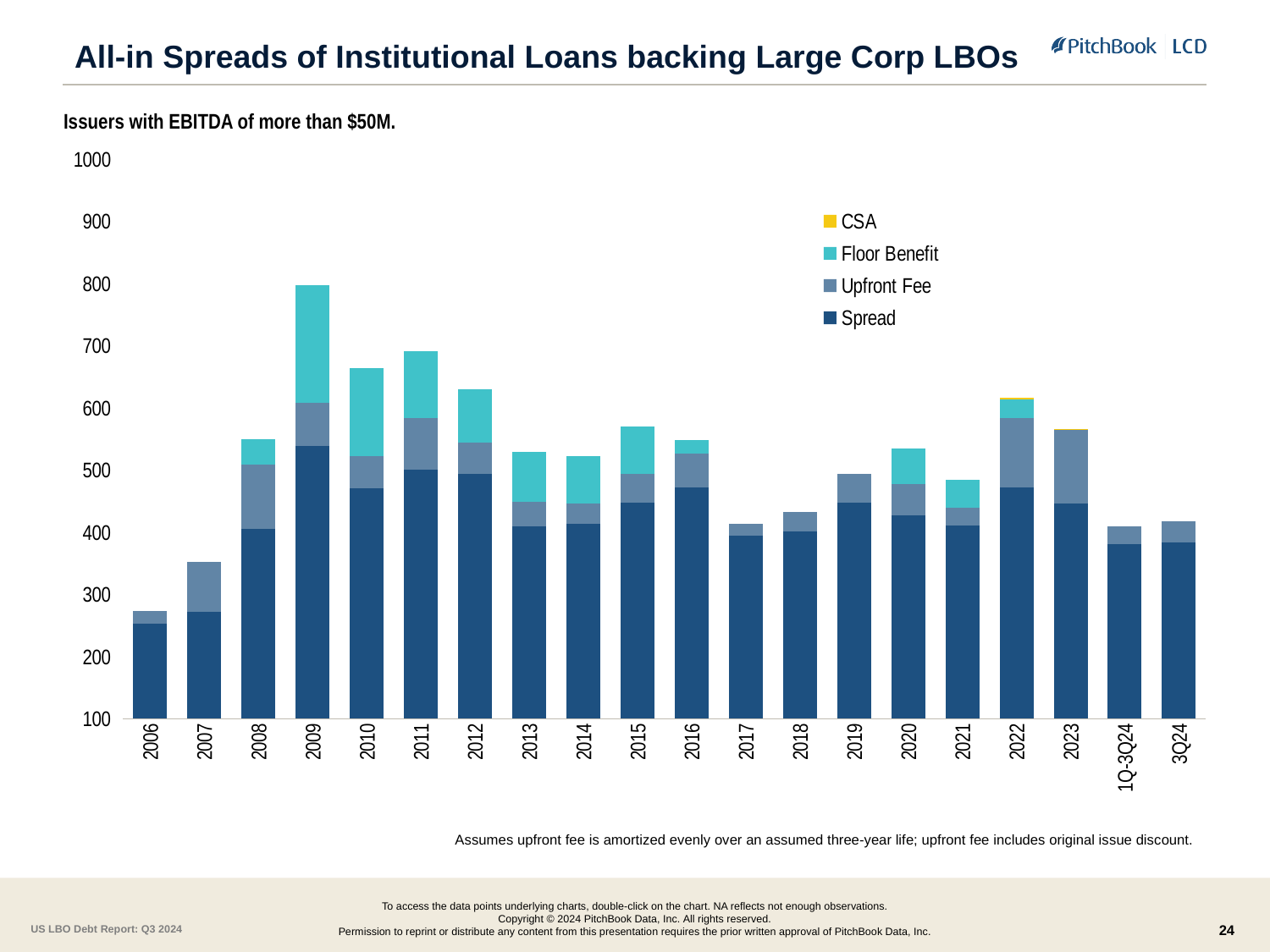
Is the total bar for 2010 greater or less than 600? greater Do the total bars rise or fall from 2009 to 2014? fall Is the total bar for 2018 greater or less than 500? less How many series does the legend list? 4 Which has the larger total bar, 2008 or 2007? 2008 How many categories are shown along the x axis? 20 Is the total bar for 2009 greater or less than 700? greater What kind of chart is shown on the slide? Stacked bar chart Which year has the highest total all-in spread? 2009 Which legend series is shown in yellow? CSA Which year has the lowest total all-in spread? 2006